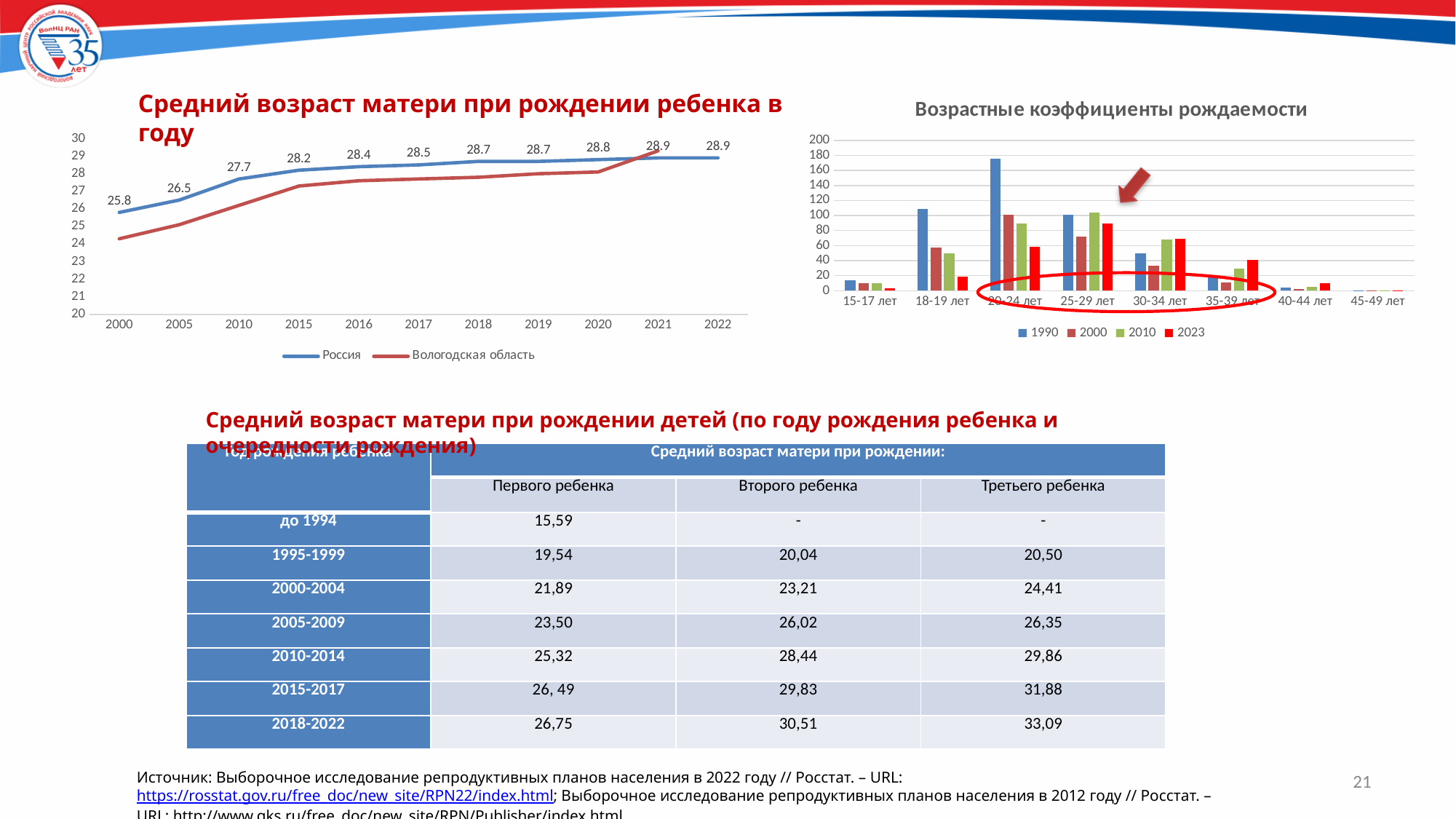
On the right chart 'Возрастные коэффициенты рождаемости', how many age groups are shown on the x axis? 8 On the left chart 'Средний возраст матери при рождении ребенка в году', what is the value for Россия in 2000? 25.8 On the left chart 'Средний возраст матери при рождении ребенка в году', what is the value for Россия in 2010? 27.7 On the left chart 'Средний возраст матери при рождении ребенка в году', what type of chart is it? line chart On the left chart 'Средний возраст матери при рождении ребенка в году', what is the value for Россия in 2020? 28.8 On the right chart 'Возрастные коэффициенты рождаемости', which age group has the highest value for 1990? 20-24 лет On the left chart 'Средний возраст матери при рождении ребенка в году', does the Россия series rise or fall from 2000 to 2022? rise On the right chart 'Возрастные коэффициенты рождаемости', which is larger for 35-39 лет: the 2023 value or the 1990 value? 2023 On the right chart 'Возрастные коэффициенты рождаемости', is the 1990 value for 20-24 лет greater or less than 160? greater On the left chart 'Средний возраст матери при рождении ребенка в году', what is the difference between the Россия values for 2015 and 2005? 1.7 On the right chart 'Возрастные коэффициенты рождаемости', how many series does the legend list? 4 On the left chart 'Средний возраст матери при рождении ребенка в году', how many series does the legend list? 2